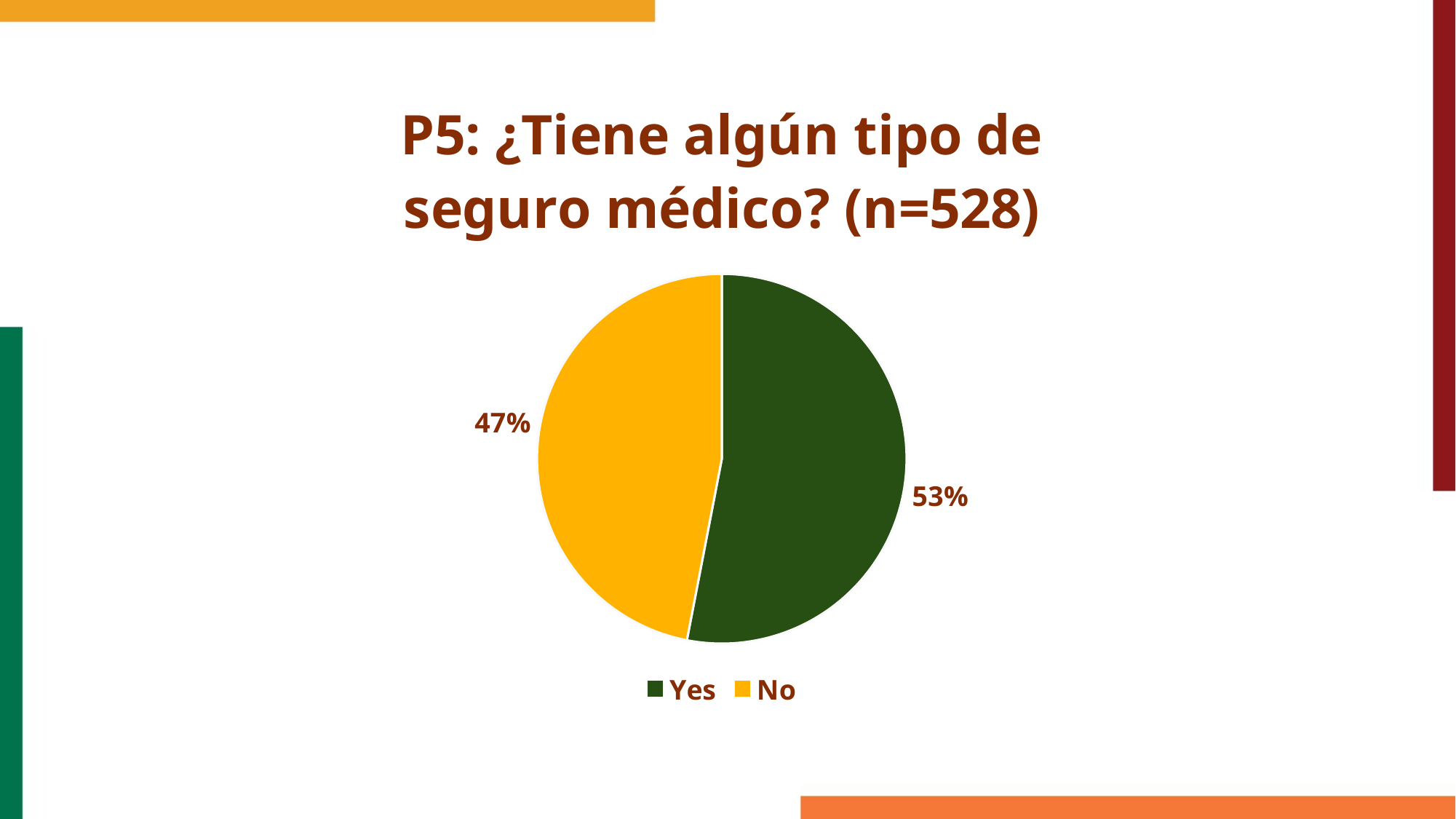
What colour is the Yes slice? dark green Is the share for Yes larger or smaller than the share for No? larger What percentage of respondents answered No? 47% What is the sample size shown in the chart title? n=528 What share of the pie does the No slice represent? 47% How many slices does the pie chart have? 2 How many entries does the legend list? 2 What is the difference in percentage points between the Yes and No slices? 6 Which response has the smaller share of the pie? No Which response has the larger share of the pie? Yes What percentage of respondents answered Yes? 53% What kind of chart is shown on the slide? pie chart